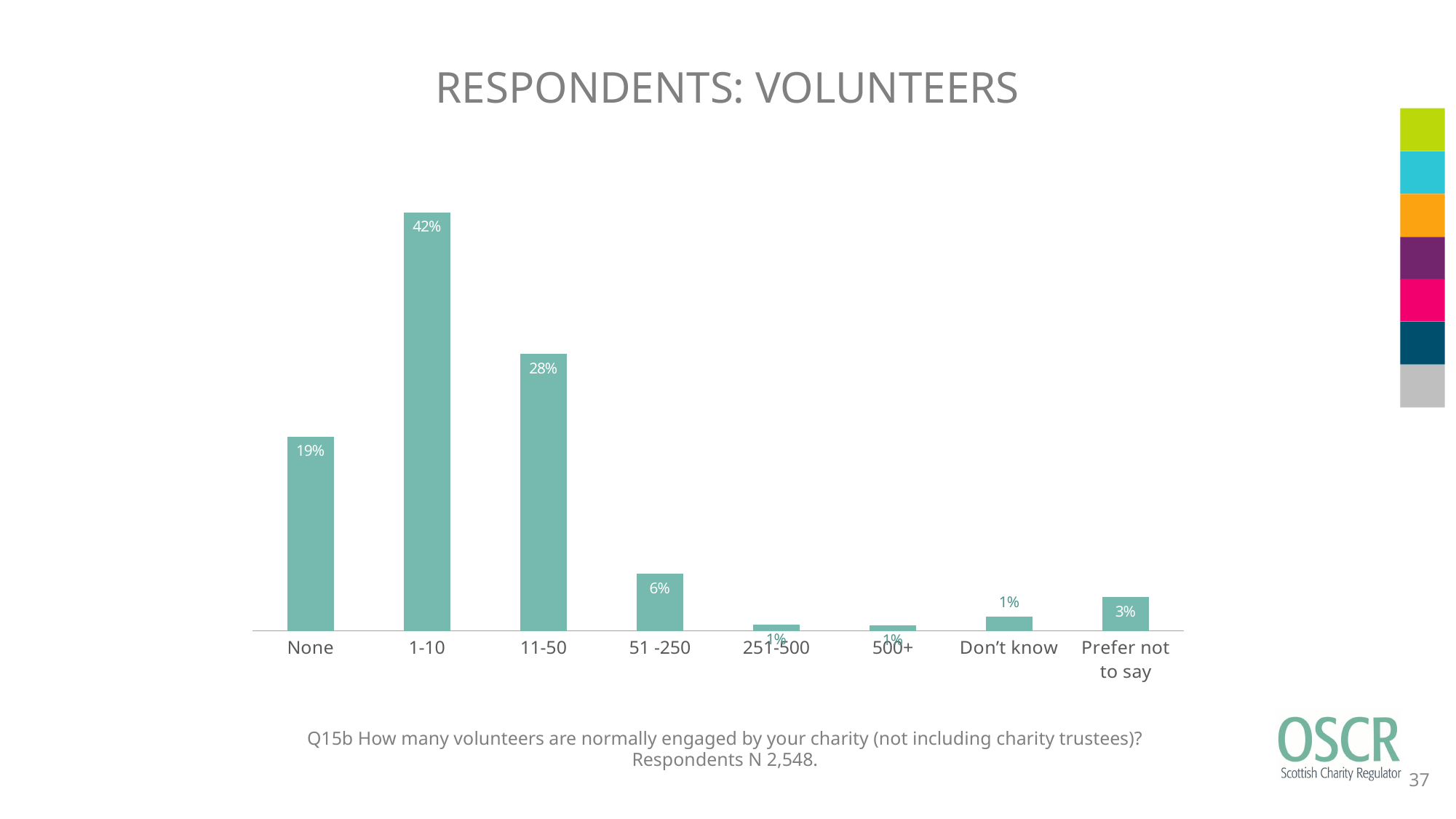
Which is larger, the value for None or the value for 11-50? 11-50 Which category has the highest value? 1-10 What is the difference between the values for 1-10 and 11-50? 14% What is the difference between the values for None and 51 -250? 13% What percentage of respondents reported having no volunteers (None)? 19% How many categories are shown on the x axis? 8 What kind of chart is shown on the slide? Bar chart What is the title of the slide? RESPONDENTS: VOLUNTEERS What is the value for the 51 -250 category? 6% What is the value shown for the 11-50 category? 28% What percentage of respondents answered 'Prefer not to say'? 3% What percentage of respondents reported having 1-10 volunteers? 42%